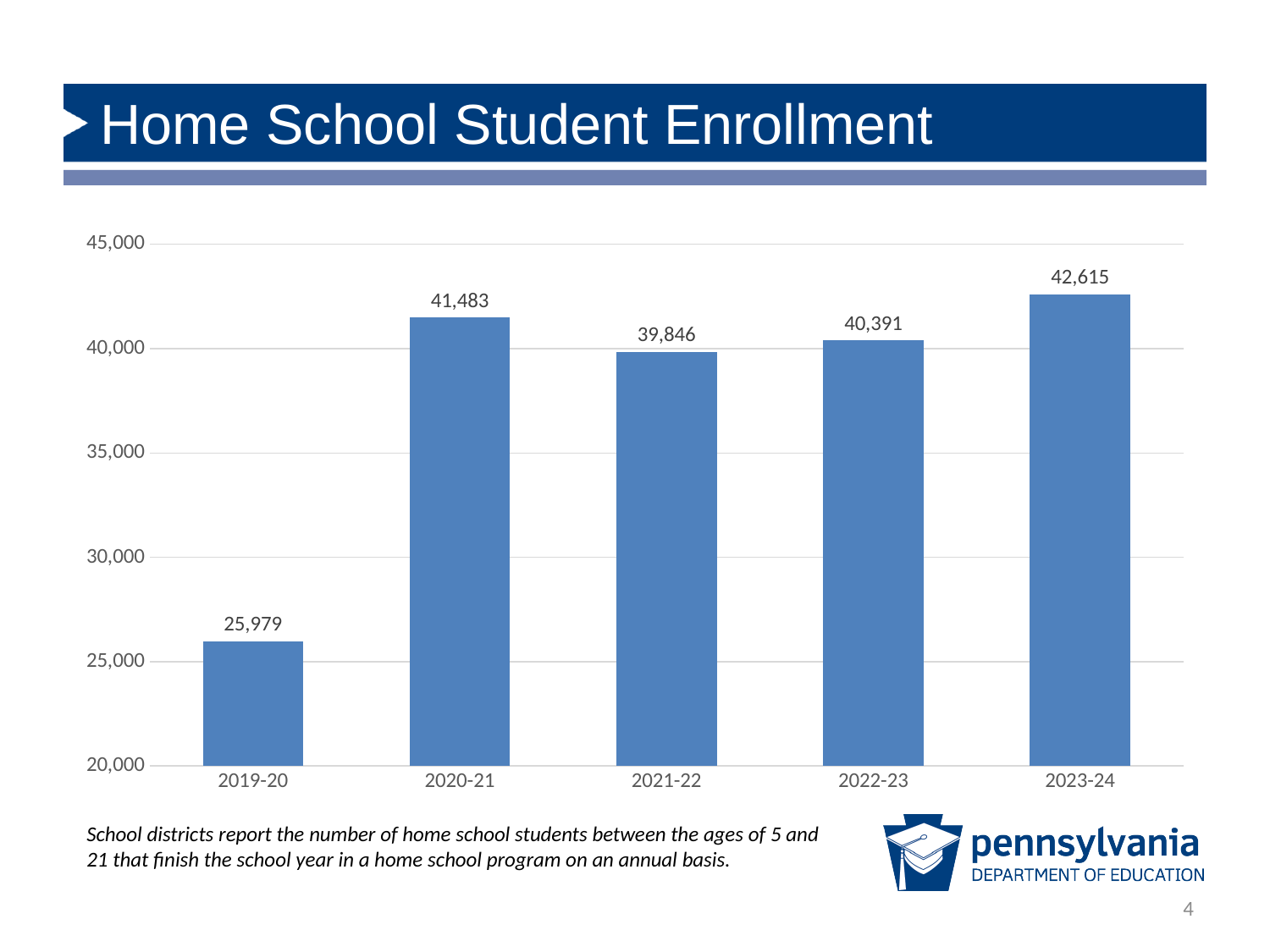
What is the title of the slide? Home School Student Enrollment Which school year has the lowest home school student enrollment? 2019-20 Is the enrollment for 2022-23 greater or less than 40,000? greater What is the home school student enrollment for 2019-20? 25,979 What kind of chart is shown on the slide? bar chart Which school year has the highest home school student enrollment? 2023-24 What is the home school student enrollment for 2021-22? 39,846 Which year has higher enrollment, 2020-21 or 2021-22? 2020-21 What is the difference in enrollment between 2020-21 and 2019-20? 15,504 What is the home school student enrollment for 2023-24? 42,615 What is the difference in enrollment between 2023-24 and 2022-23? 2,224 How many school years are shown in the chart? 5